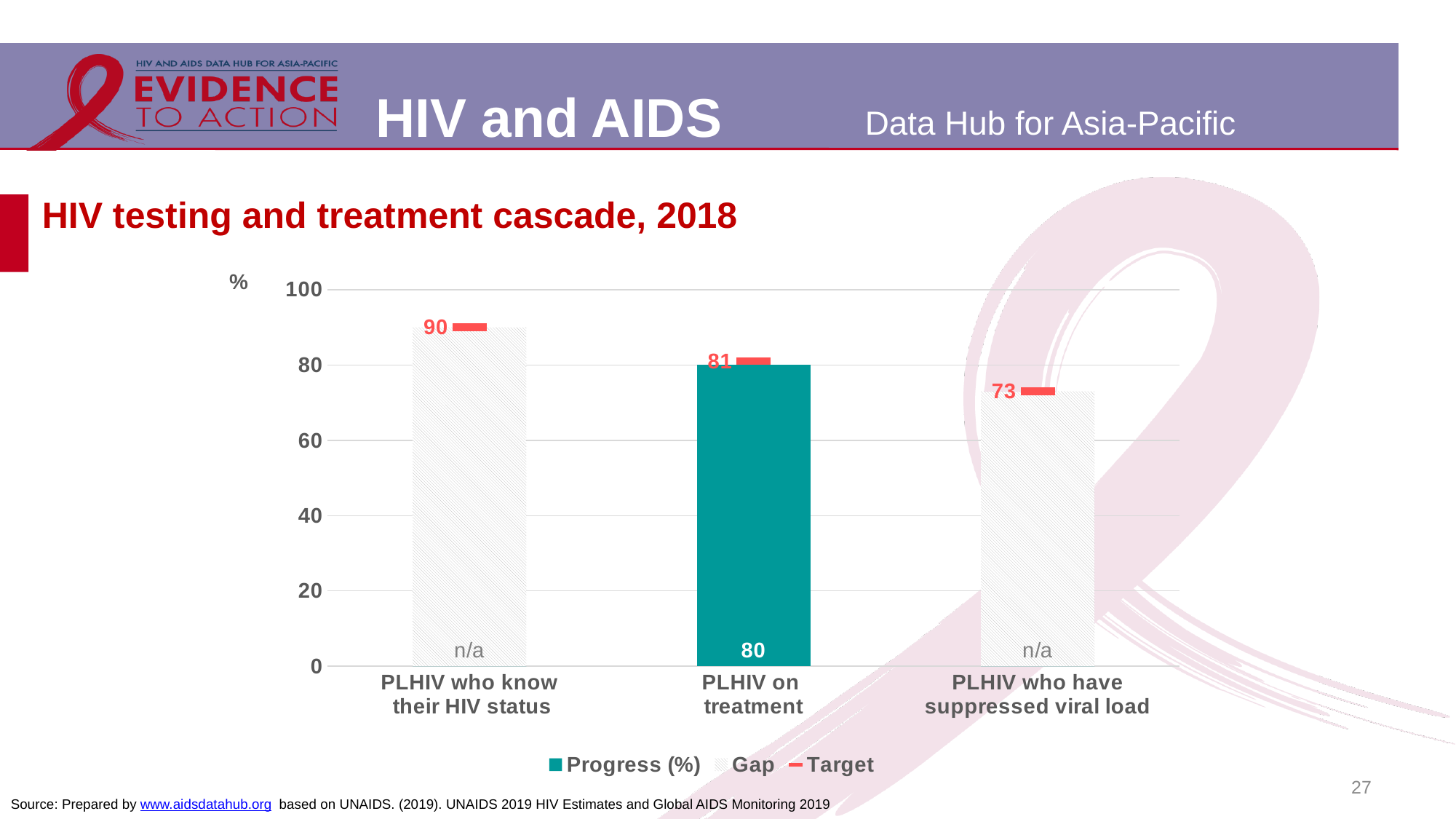
How many series does the chart legend list? 3 Which category has the highest target value? PLHIV who know their HIV status What is the difference between the target for PLHIV who know their HIV status and the target for PLHIV who have suppressed viral load? 17 What is the target value for PLHIV who have suppressed viral load? 73 What is the target value for PLHIV on treatment? 81 How many categories are shown on the x axis of the chart? 3 What kind of chart is shown on the slide? Bar chart What is the progress value shown for PLHIV on treatment? 80 What progress value is shown for PLHIV who know their HIV status? n/a What is the difference between the target and the progress value for PLHIV on treatment? 1 What is the target value for PLHIV who know their HIV status? 90 Which category has the lowest target value? PLHIV who have suppressed viral load